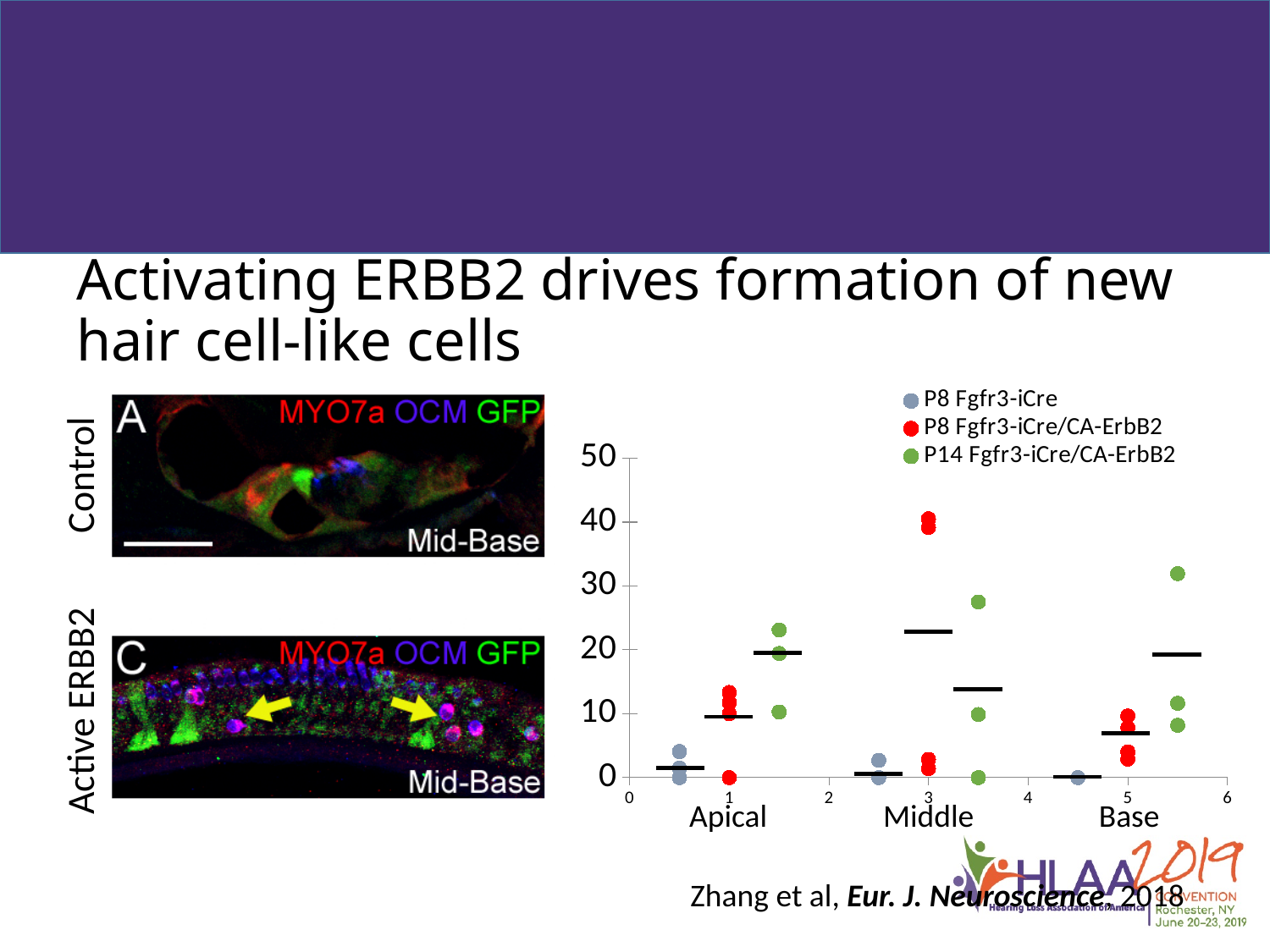
How many series does the chart legend list? 3 In which region does the P8 Fgfr3-iCre/CA-ErbB2 (red) series reach its highest values? Middle Which series in the chart legend is shown in red? P8 Fgfr3-iCre/CA-ErbB2 What kind of chart is shown on the slide? scatter chart Is the highest P14 Fgfr3-iCre/CA-ErbB2 (green) point in the Middle region greater or less than 20? greater What are the three region labels along the x axis of the chart? Apical, Middle, Base Is the highest P14 Fgfr3-iCre/CA-ErbB2 (green) point in the Base region greater or less than 30? greater Are all the P8 Fgfr3-iCre (gray) points in the Apical region greater or less than 10? less How many cochlear regions are labelled along the x axis of the chart? 3 Is the highest P14 Fgfr3-iCre/CA-ErbB2 (green) point larger in the Base region or the Apical region? Base Which series has the lowest values across all three regions? P8 Fgfr3-iCre